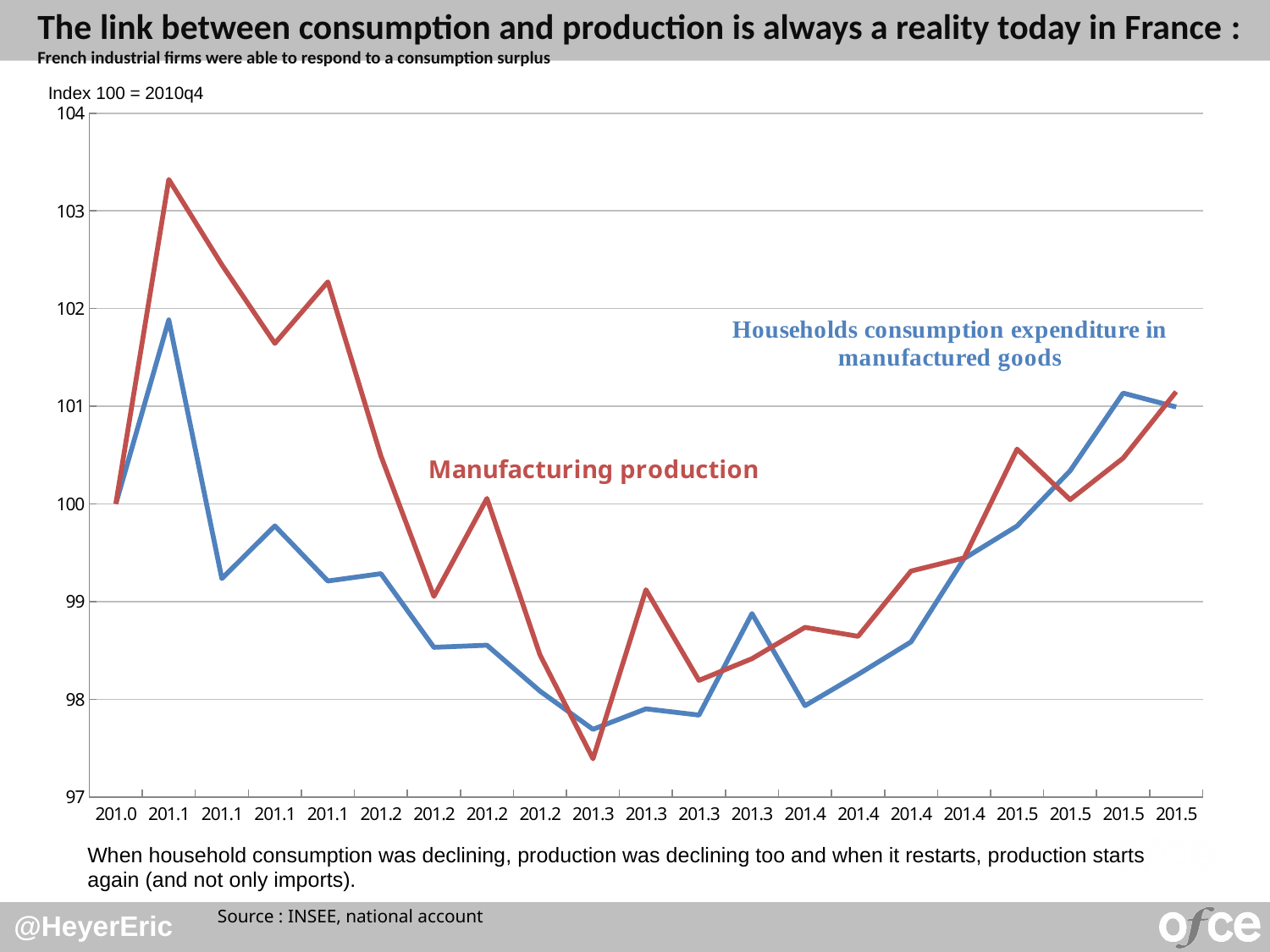
Is the peak value of Manufacturing production greater or less than 103? greater Is the lowest value of Manufacturing production greater or less than 98? less Which series reaches the highest value on the chart? Manufacturing production What colour is the Manufacturing production line? red How many series are plotted on the chart? 2 Do the two series rise or fall over the last part of the chart, from their lowest points to the final point? rise What is the value of Manufacturing production at the first point (201.0)? 100 Is the lowest value of Households consumption expenditure in manufactured goods greater or less than 98? less At the second point on the x axis, which series has the higher value: Manufacturing production or Households consumption expenditure in manufactured goods? Manufacturing production What kind of chart is shown on the slide? line chart Which series reaches the lowest value on the chart? Manufacturing production What is the value of Households consumption expenditure in manufactured goods at the first point (201.0)? 100